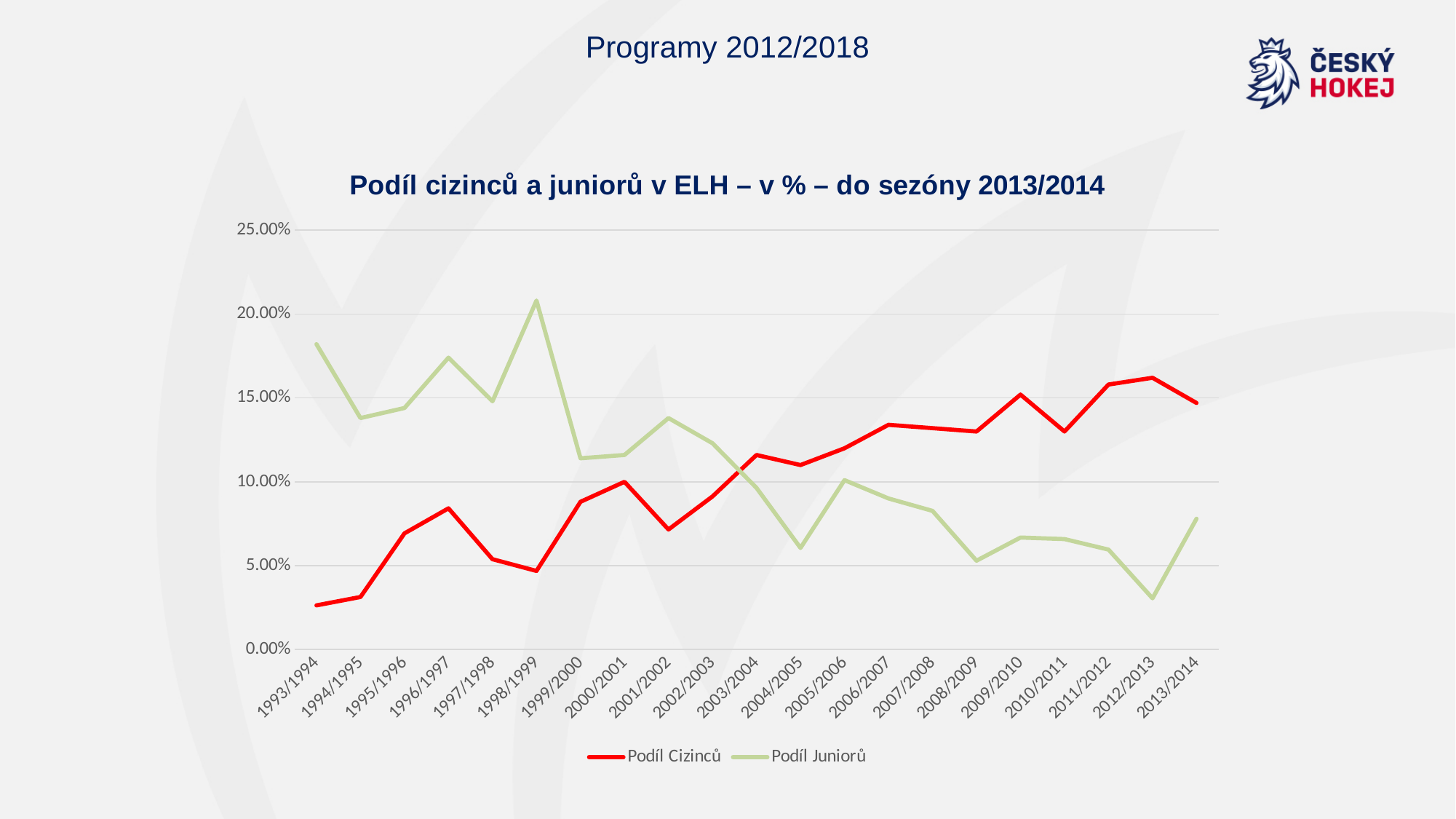
In which season does Podíl Juniorů reach its highest value? 1998/1999 Which series has the higher value in 1993/1994, Podíl Cizinců or Podíl Juniorů? Podíl Juniorů Which series has the higher value in 2013/2014, Podíl Cizinců or Podíl Juniorů? Podíl Cizinců What kind of chart is shown on the slide? line chart Is the value of Podíl Juniorů for 1998/1999 greater or less than 20.00%? greater How many seasons are plotted along the x axis? 21 Is the value of Podíl Cizinců for 1993/1994 greater or less than 5.00%? less Is the value of Podíl Cizinců for 2001/2002 greater or less than 10.00%? less Overall, does Podíl Cizinců rise or fall from 1993/1994 to 2013/2014? rise In which season does Podíl Juniorů reach its lowest value? 2012/2013 How many series does the legend list? 2